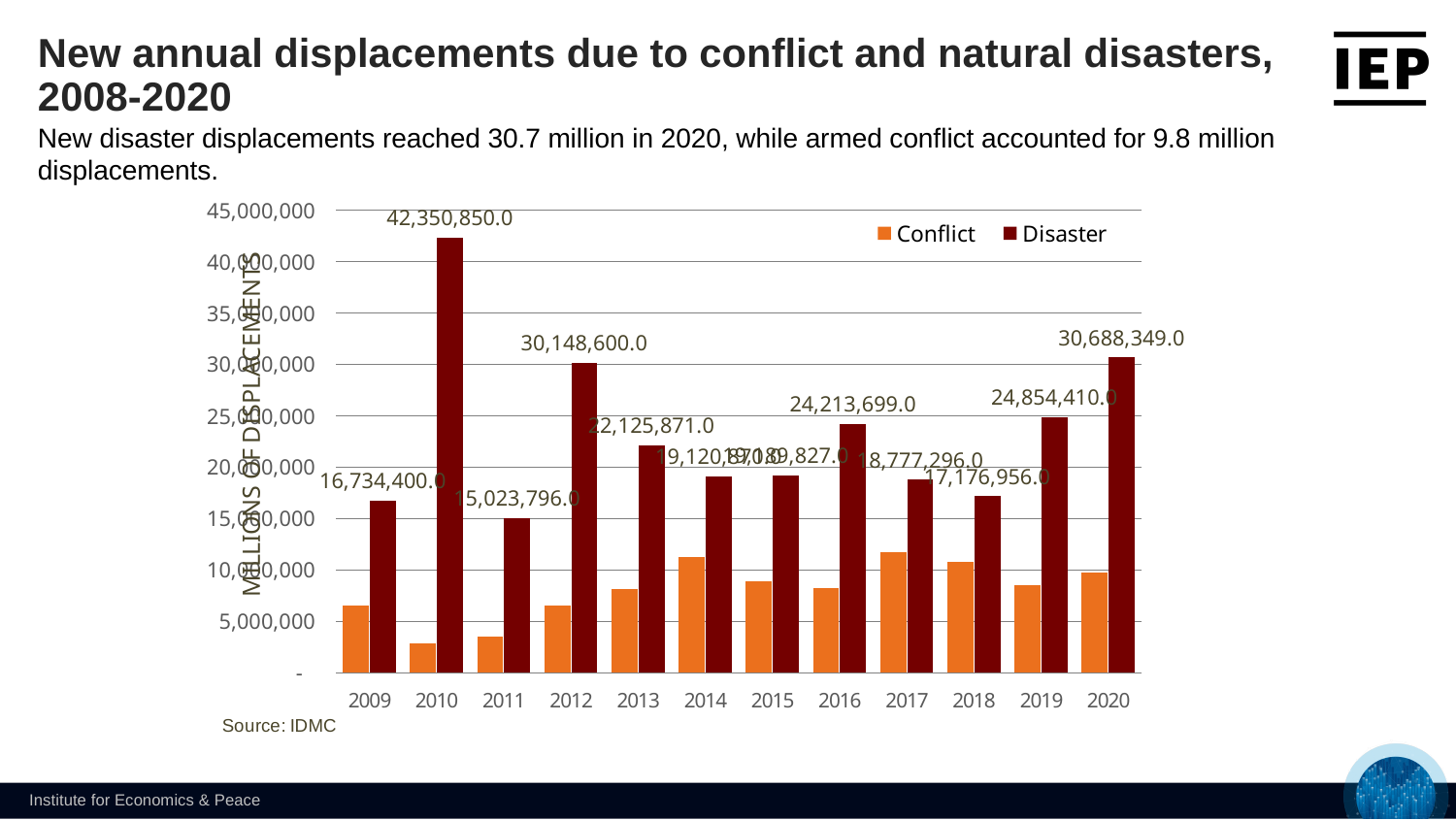
What is the difference between the Disaster values for 2020 and 2019? 5,833,939.0 Which is larger, the Disaster value for 2012 or for 2020? 2020 Is the Conflict value for 2017 greater or less than 10,000,000? greater What source is cited below the chart? IDMC Which year has the lowest Disaster value? 2011 What is the Disaster value for 2017? 18,777,296.0 How many years are shown on the x axis of the chart? 12 What is the Disaster value for 2010? 42,350,850.0 What kind of chart is shown on the slide? Bar chart How many series does the legend list? 2 Is the Conflict value for 2010 greater or less than 5,000,000? less Which year has the highest Disaster value? 2010